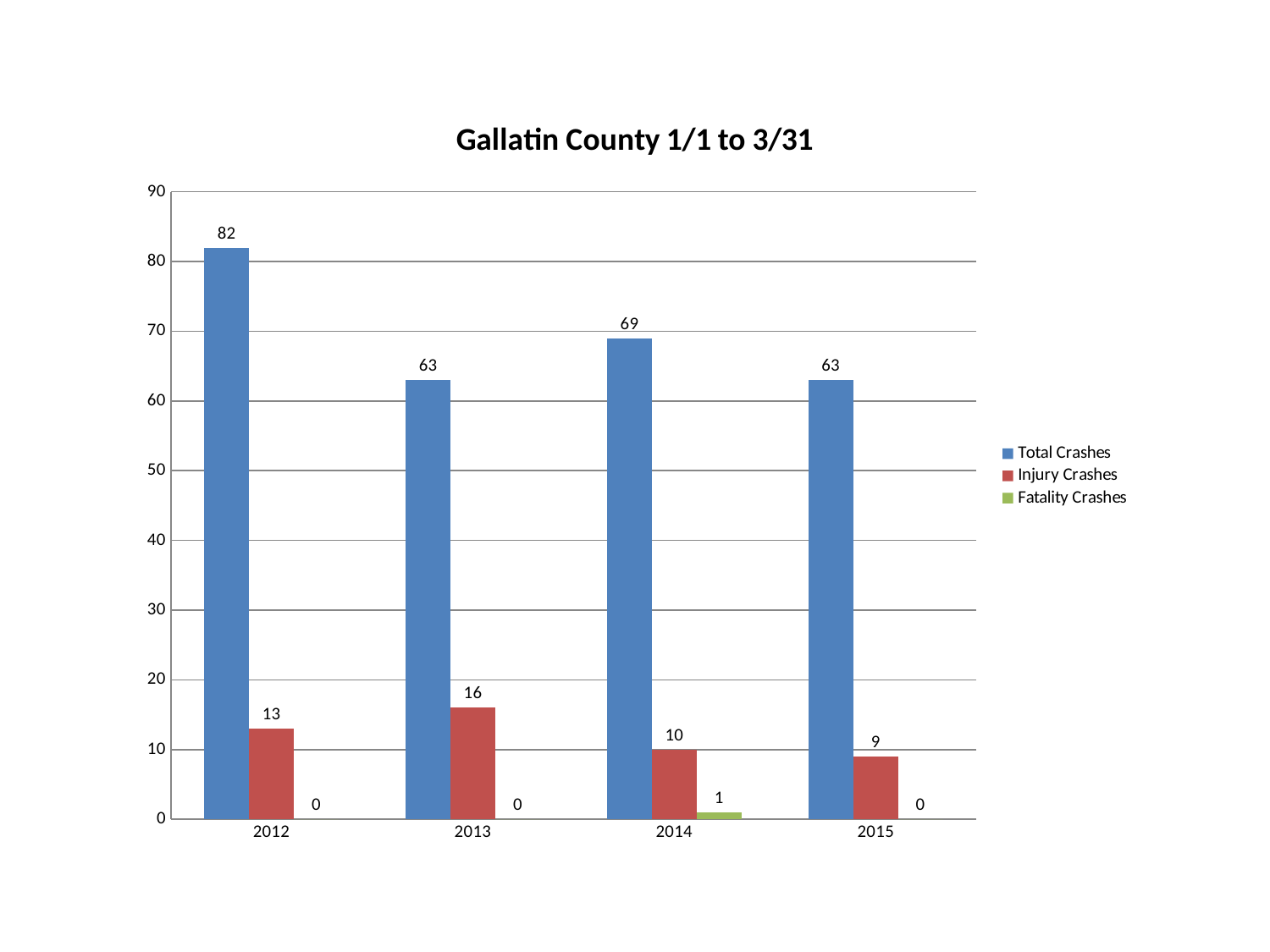
What is the title of the chart? Gallatin County 1/1 to 3/31 How many years are shown on the x axis? 4 What is the value for Fatality Crashes in 2014? 1 What kind of chart is shown? bar chart What colour are the Injury Crashes bars? red What is the value for Total Crashes in 2012? 82 How many series does the legend list? 3 Which year has the highest Total Crashes? 2012 What is the difference between Total Crashes in 2012 and 2014? 13 What is the value for Injury Crashes in 2013? 16 Which year has the lowest Injury Crashes? 2015 Which is larger, Injury Crashes in 2012 or Injury Crashes in 2014? Injury Crashes in 2012